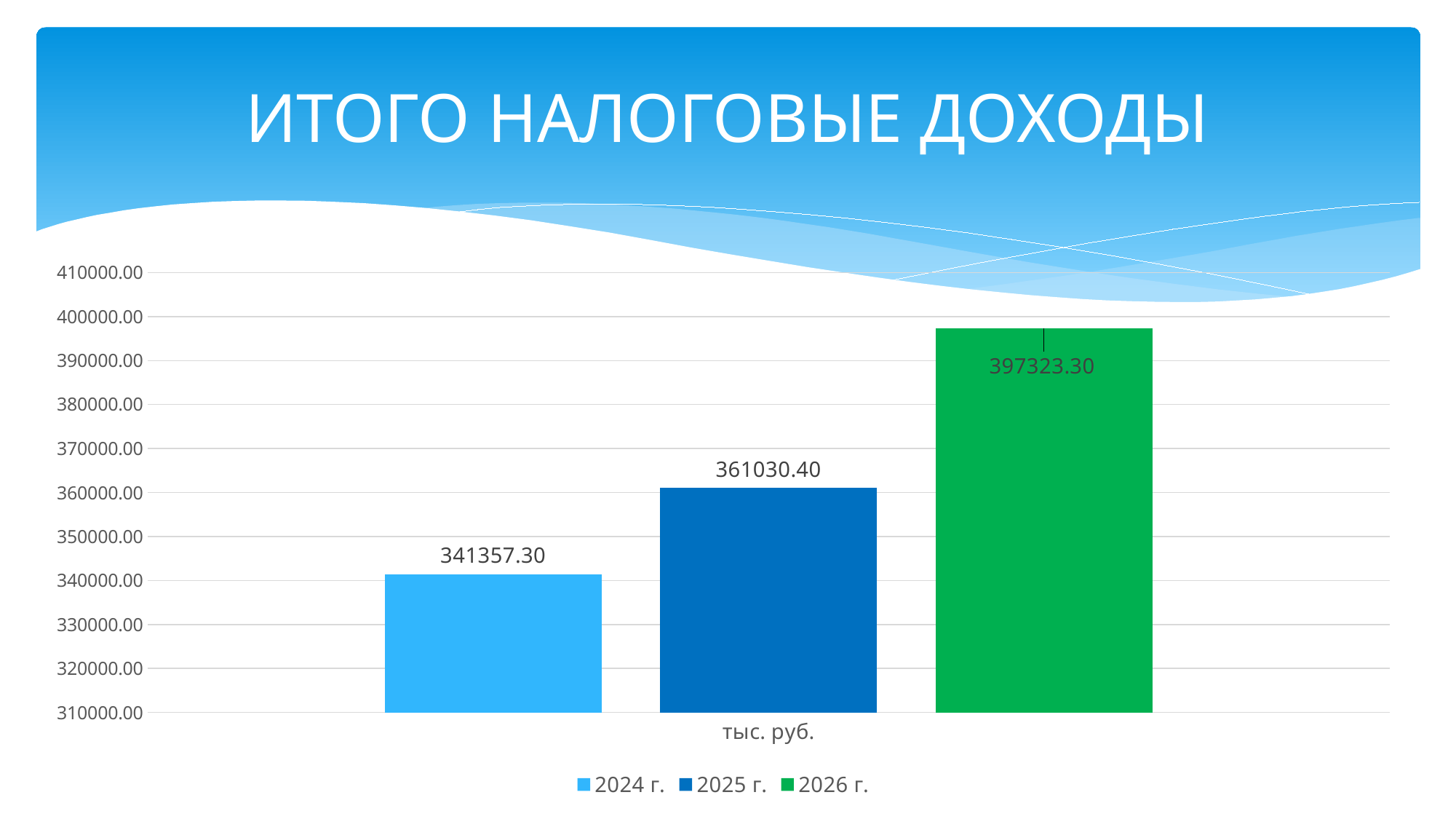
What is the value for 2025 г.? 361030.40 What is the title of the slide? ИТОГО НАЛОГОВЫЕ ДОХОДЫ What is the difference between the values for 2025 г. and 2024 г.? 19673.10 Which is larger, the value for 2024 г. or the value for 2025 г.? 2025 г. What kind of chart is shown on the slide? bar chart What is the value for 2026 г.? 397323.30 Is the value for 2026 г. greater or less than 390000.00? greater What is the difference between the values for 2026 г. and 2025 г.? 36292.90 How many series does the legend list? 3 Which year has the lowest value? 2024 г. Which year has the highest value? 2026 г. What is the value for 2024 г.? 341357.30